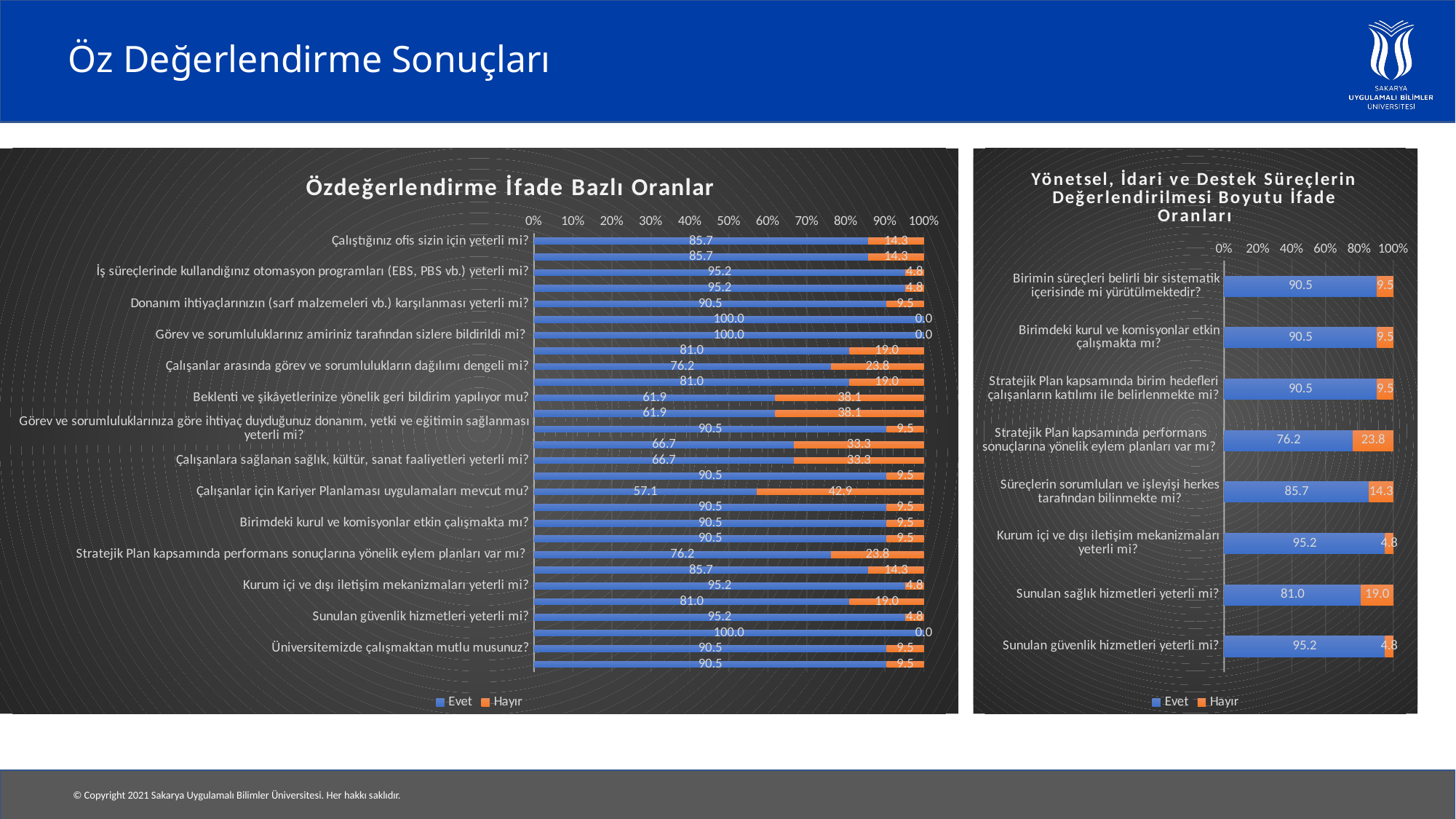
In the chart titled "Yönetsel, İdari ve Destek Süreçlerin Değerlendirilmesi Boyutu İfade Oranları", how many categories are shown? 8 In the chart titled "Yönetsel, İdari ve Destek Süreçlerin Değerlendirilmesi Boyutu İfade Oranları", what is the Evet value for "Sunulan sağlık hizmetleri yeterli mi?"? 81.0 In the chart titled "Özdeğerlendirme İfade Bazlı Oranlar", what is the Evet value for "Çalışanlar için Kariyer Planlaması uygulamaları mevcut mu?"? 57.1 What type of chart is the chart titled "Yönetsel, İdari ve Destek Süreçlerin Değerlendirilmesi Boyutu İfade Oranları"? Stacked bar chart In the chart titled "Özdeğerlendirme İfade Bazlı Oranlar", what is the Evet value for "Görev ve sorumluluklarınız amiriniz tarafından sizlere bildirildi mi?"? 100.0 In the chart titled "Yönetsel, İdari ve Destek Süreçlerin Değerlendirilmesi Boyutu İfade Oranları", what is the difference between the Evet and Hayır values for "Süreçlerin sorumluları ve işleyişi herkes tarafından bilinmekte mi?"? 71.4 In the chart titled "Yönetsel, İdari ve Destek Süreçlerin Değerlendirilmesi Boyutu İfade Oranları", what is the Hayır value for "Stratejik Plan kapsamında performans sonuçlarına yönelik eylem planları var mı?"? 23.8 In the chart titled "Özdeğerlendirme İfade Bazlı Oranlar", which labelled category has the highest Hayır value? Çalışanlar için Kariyer Planlaması uygulamaları mevcut mu? In the chart titled "Yönetsel, İdari ve Destek Süreçlerin Değerlendirilmesi Boyutu İfade Oranları", which is larger: the Evet value for "Sunulan sağlık hizmetleri yeterli mi?" or for "Sunulan güvenlik hizmetleri yeterli mi?"? Sunulan güvenlik hizmetleri yeterli mi? In the chart titled "Özdeğerlendirme İfade Bazlı Oranlar", what is the Hayır value for "Beklenti ve şikâyetlerinize yönelik geri bildirim yapılıyor mu?"? 38.1 How many series does the legend of the chart titled "Özdeğerlendirme İfade Bazlı Oranlar" list? 2 In the chart titled "Yönetsel, İdari ve Destek Süreçlerin Değerlendirilmesi Boyutu İfade Oranları", which category has the lowest Evet value? Stratejik Plan kapsamında performans sonuçlarına yönelik eylem planları var mı?